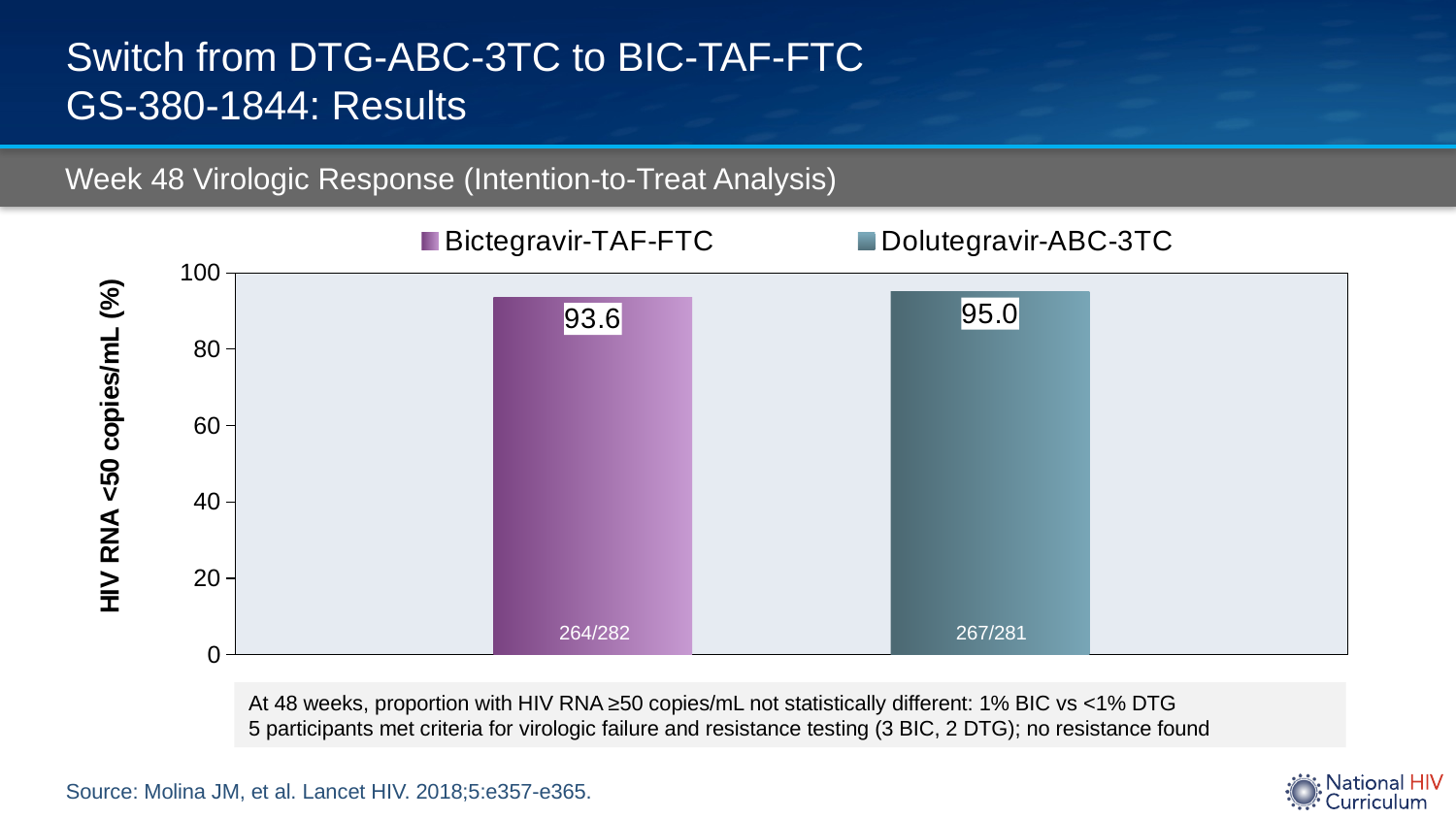
What is the maximum value shown on the y axis? 100 What fraction is printed inside the Dolutegravir-ABC-3TC bar? 267/281 Which series has the lower value? Bictegravir-TAF-FTC What is the y-axis label of the chart? HIV RNA <50 copies/mL (%) Is the value for Bictegravir-TAF-FTC greater or less than 80? greater What is the value for Dolutegravir-ABC-3TC? 95.0 What fraction is printed inside the Bictegravir-TAF-FTC bar? 264/282 What is the difference between the Dolutegravir-ABC-3TC and Bictegravir-TAF-FTC values? 1.4 What is the value for Bictegravir-TAF-FTC? 93.6 How many series does the legend list? 2 What kind of chart is shown? bar chart Which series has the higher value? Dolutegravir-ABC-3TC